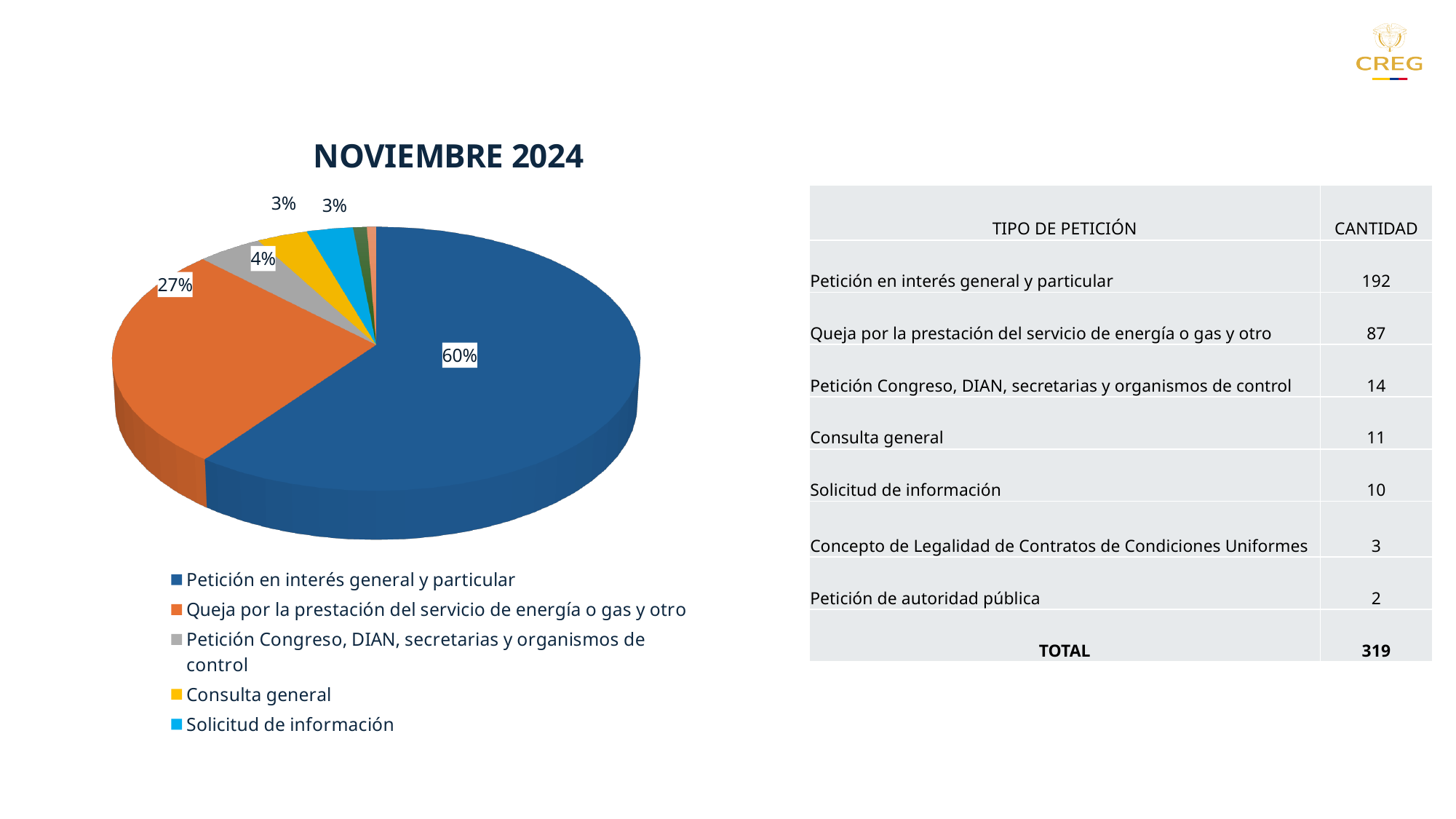
What is the difference in percentage points between the 'Petición en interés general y particular' slice and the 'Queja por la prestación del servicio de energía o gas y otro' slice? 33% How many entries does the legend of the pie chart list? 5 Which slice is larger: 'Queja por la prestación del servicio de energía o gas y otro' or 'Petición Congreso, DIAN, secretarias y organismos de control'? Queja por la prestación del servicio de energía o gas y otro What colour is the largest slice of the pie chart? blue What percentage is shown for 'Petición Congreso, DIAN, secretarias y organismos de control'? 4% What share of the pie does 'Petición en interés general y particular' represent? 60% What share of the pie does 'Queja por la prestación del servicio de energía o gas y otro' represent? 27% What percentage is shown for 'Consulta general'? 3% What kind of chart is shown on the slide? pie chart Which category has the largest slice of the pie? Petición en interés general y particular What percentage is shown for 'Solicitud de información'? 3% What is the title of the pie chart? NOVIEMBRE 2024